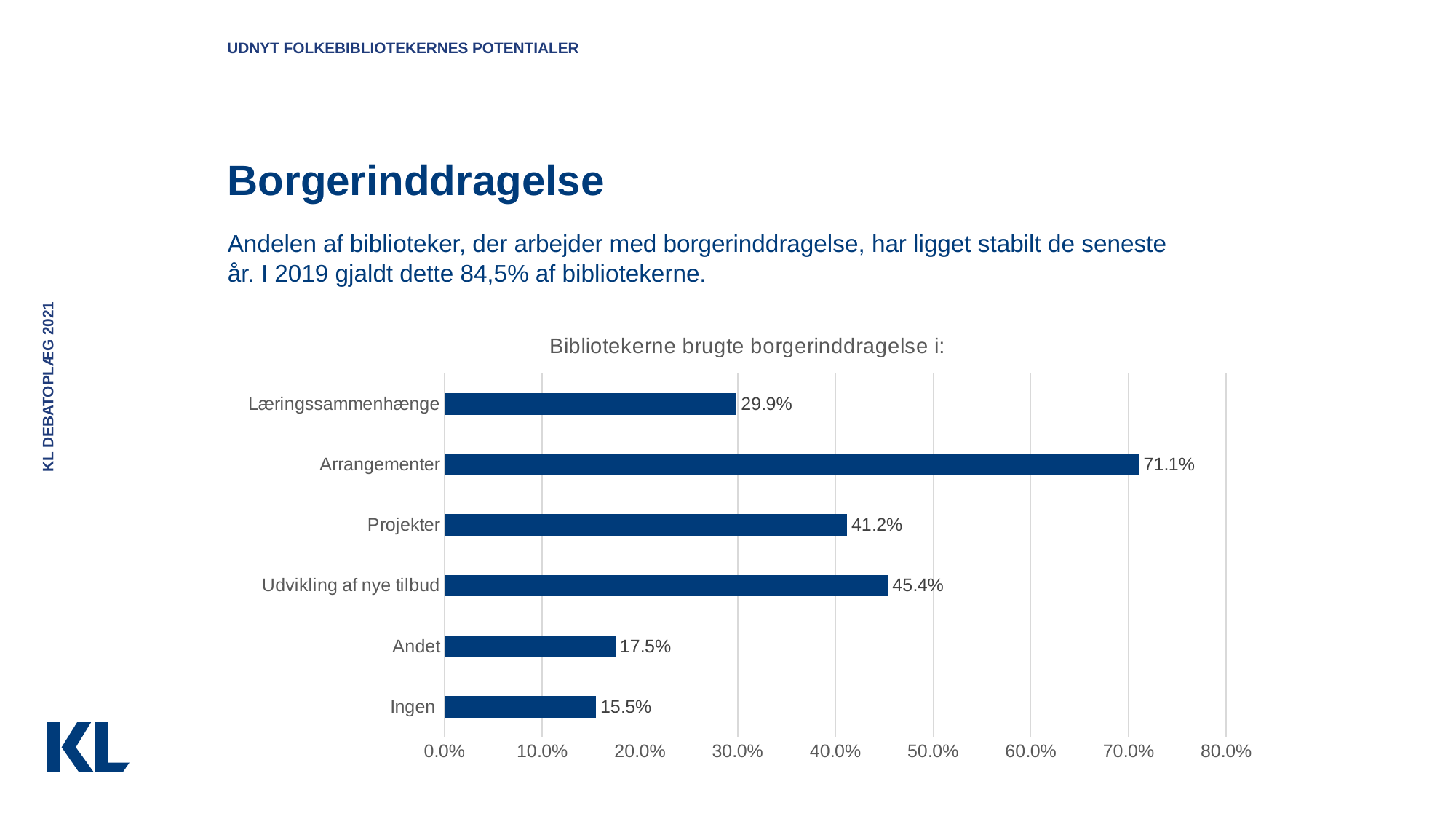
How many categories are shown in the chart? 6 What is the difference between the values for Arrangementer and Læringssammenhænge? 41.2% Which category has the lowest value? Ingen Which category has the highest value? Arrangementer What is the difference between the values for Udvikling af nye tilbud and Projekter? 4.2% What is the title of the chart? Bibliotekerne brugte borgerinddragelse i: What is the value for Arrangementer? 71.1% What kind of chart is shown on the slide? Bar chart Which is larger, the value for Andet or the value for Ingen? Andet What is the value for Ingen? 15.5% What is the value for Læringssammenhænge? 29.9% Is the value for Projekter greater or less than 40.0%? greater